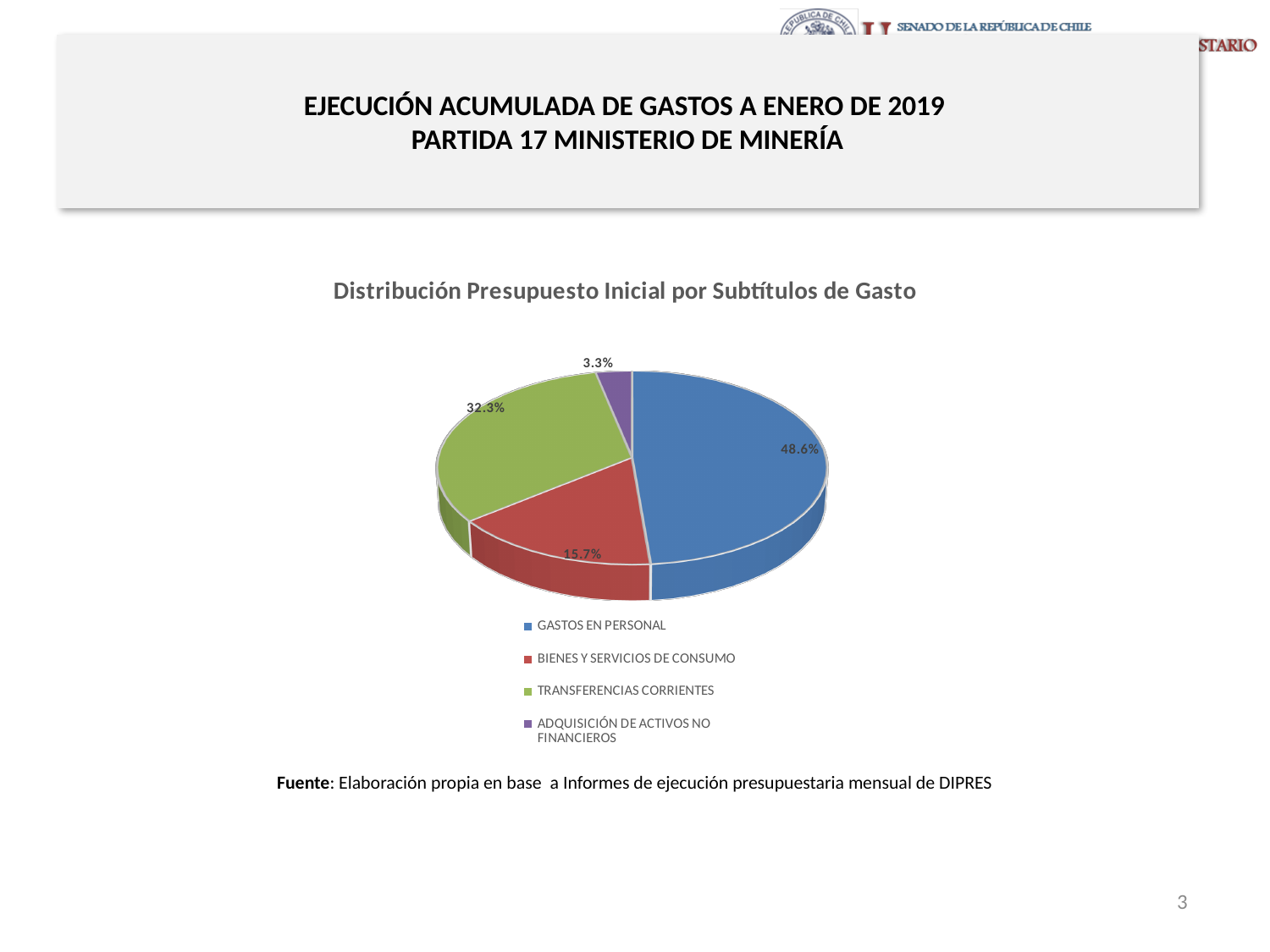
Which is larger, the share for BIENES Y SERVICIOS DE CONSUMO or the share for TRANSFERENCIAS CORRIENTES? TRANSFERENCIAS CORRIENTES What is the title of the chart? Distribución Presupuesto Inicial por Subtítulos de Gasto Which category has the smallest slice of the pie? ADQUISICIÓN DE ACTIVOS NO FINANCIEROS What share of the pie does TRANSFERENCIAS CORRIENTES represent? 32.3% What is the difference in percentage points between GASTOS EN PERSONAL and TRANSFERENCIAS CORRIENTES? 16.3 How many categories are shown in the pie chart? 4 What share of the pie does ADQUISICIÓN DE ACTIVOS NO FINANCIEROS represent? 3.3% What type of chart is shown on the slide? Pie chart What share of the pie does BIENES Y SERVICIOS DE CONSUMO represent? 15.7% What colour is the slice for TRANSFERENCIAS CORRIENTES? Green Which category has the largest slice of the pie? GASTOS EN PERSONAL